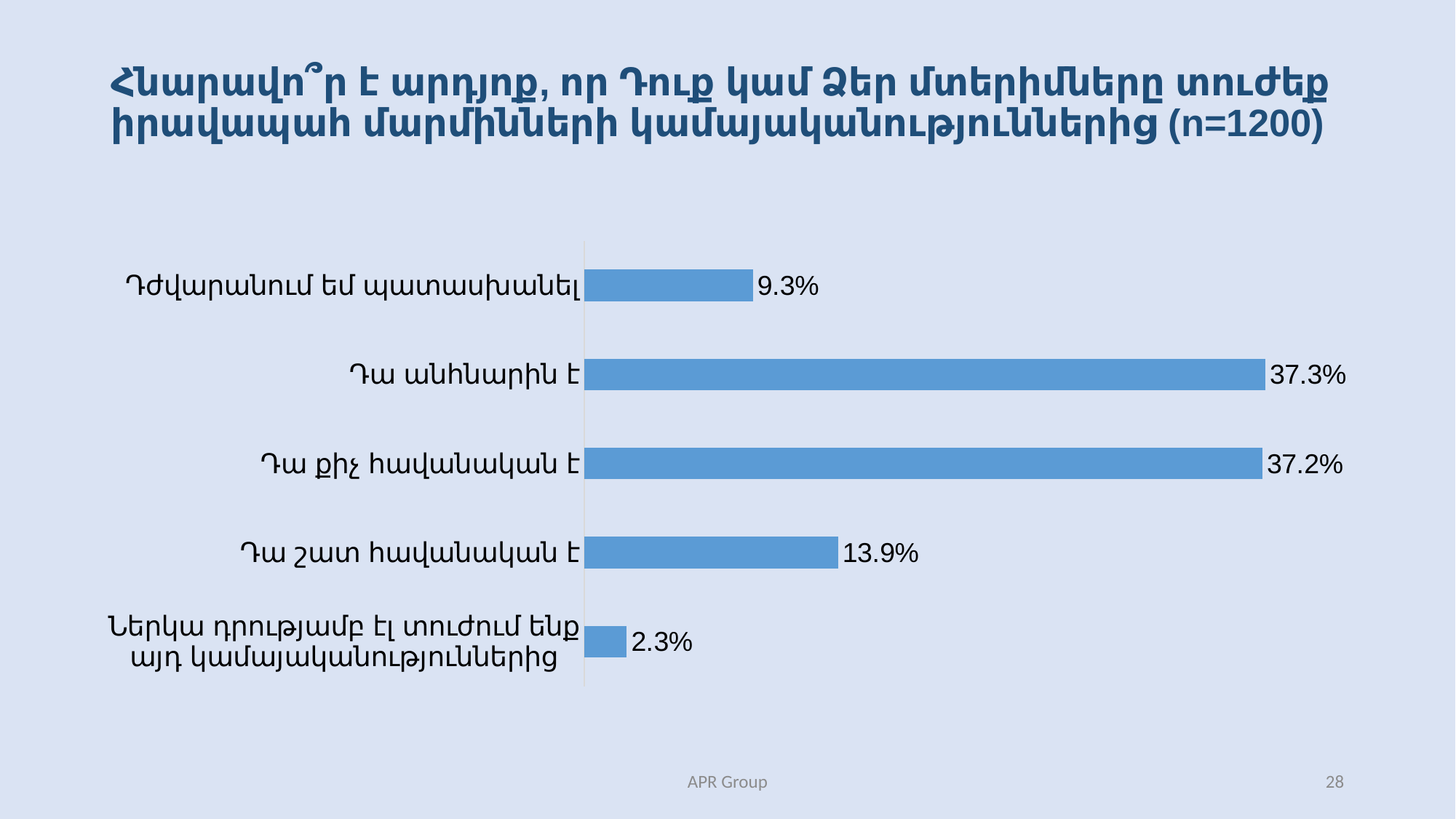
What is the value for "Դժվարանում եմ պատասխանել"? 9.3% What is the value for "Դա անհնարին է"? 37.3% What is the value for "Դա քիչ հավանական է"? 37.2% How many categories does the chart show? 5 Which is larger: the value for "Դա շատ հավանական է" or the value for "Դժվարանում եմ պատասխանել"? Դա շատ հավանական է What kind of chart is shown on the slide? bar chart What sample size (n) is stated in the chart title? n=1200 Which category has the highest value? Դա անհնարին է What is the value for "Դա շատ հավանական է"? 13.9% What is the value for "Ներկա դրությամբ էլ տուժում ենք այդ կամայականություններից"? 2.3% What is the difference between the values for "Դա շատ հավանական է" and "Դժվարանում եմ պատասխանել"? 4.6% Which category has the lowest value? Ներկա դրությամբ էլ տուժում ենք այդ կամայականություններից